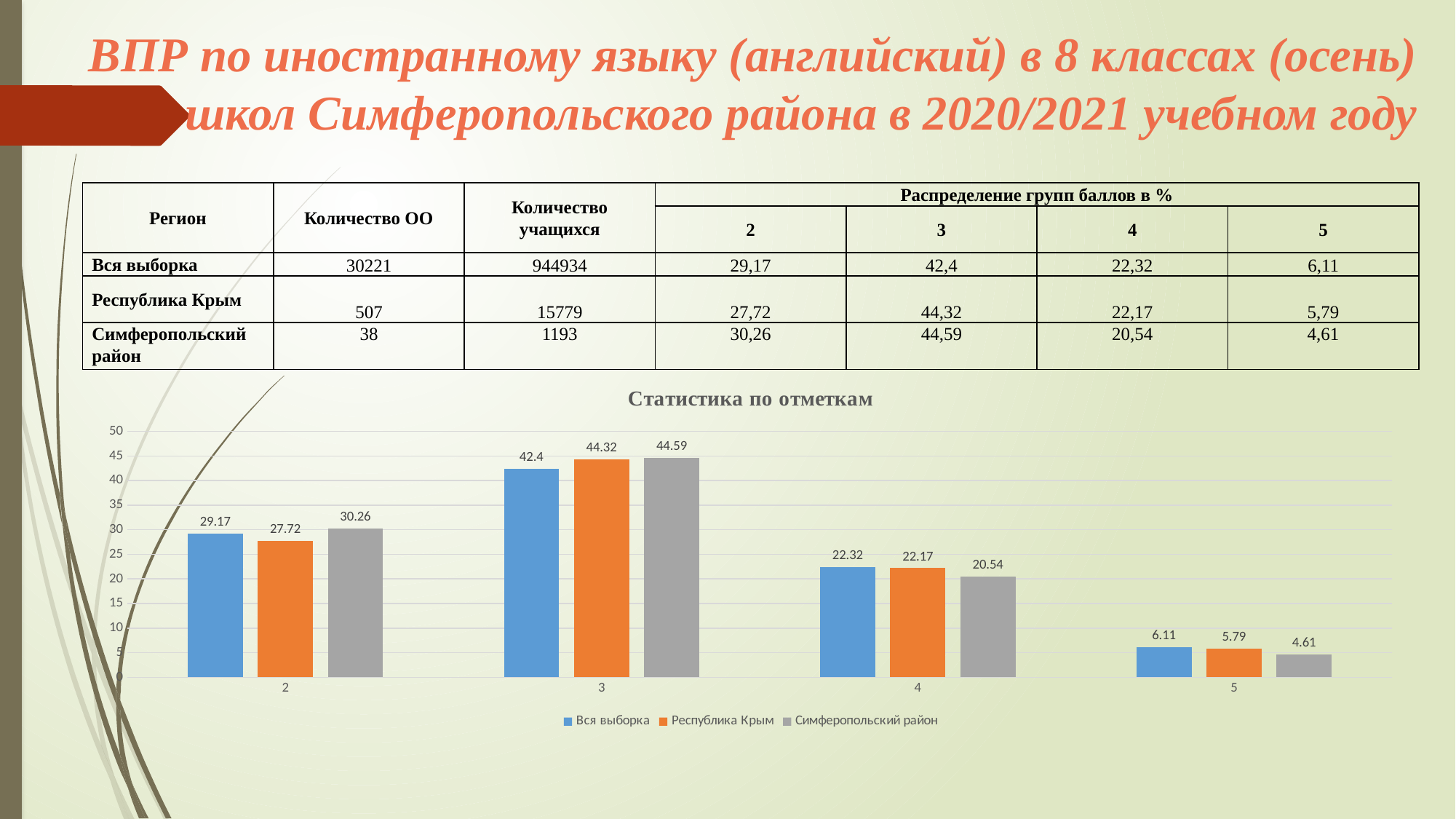
At mark 4, which is larger: Вся выборка or Симферопольский район? Вся выборка What is the value for Симферопольский район at mark 3? 44.59 What type of chart is shown on the slide? Bar chart What is the difference between the Симферопольский район values at mark 3 and mark 2? 14.33 For the Республика Крым series, which mark has the lowest value? 5 What is the value for Вся выборка at mark 2 in the chart? 29.17 What is the difference between Вся выборка and Республика Крым at mark 2? 1.45 How many series does the chart legend list? 3 What is the value for Республика Крым at mark 5? 5.79 How many mark categories are shown on the x axis of the chart? 4 What is the value for Симферопольский район at mark 4? 20.54 For the Симферопольский район series, which mark has the highest value? 3